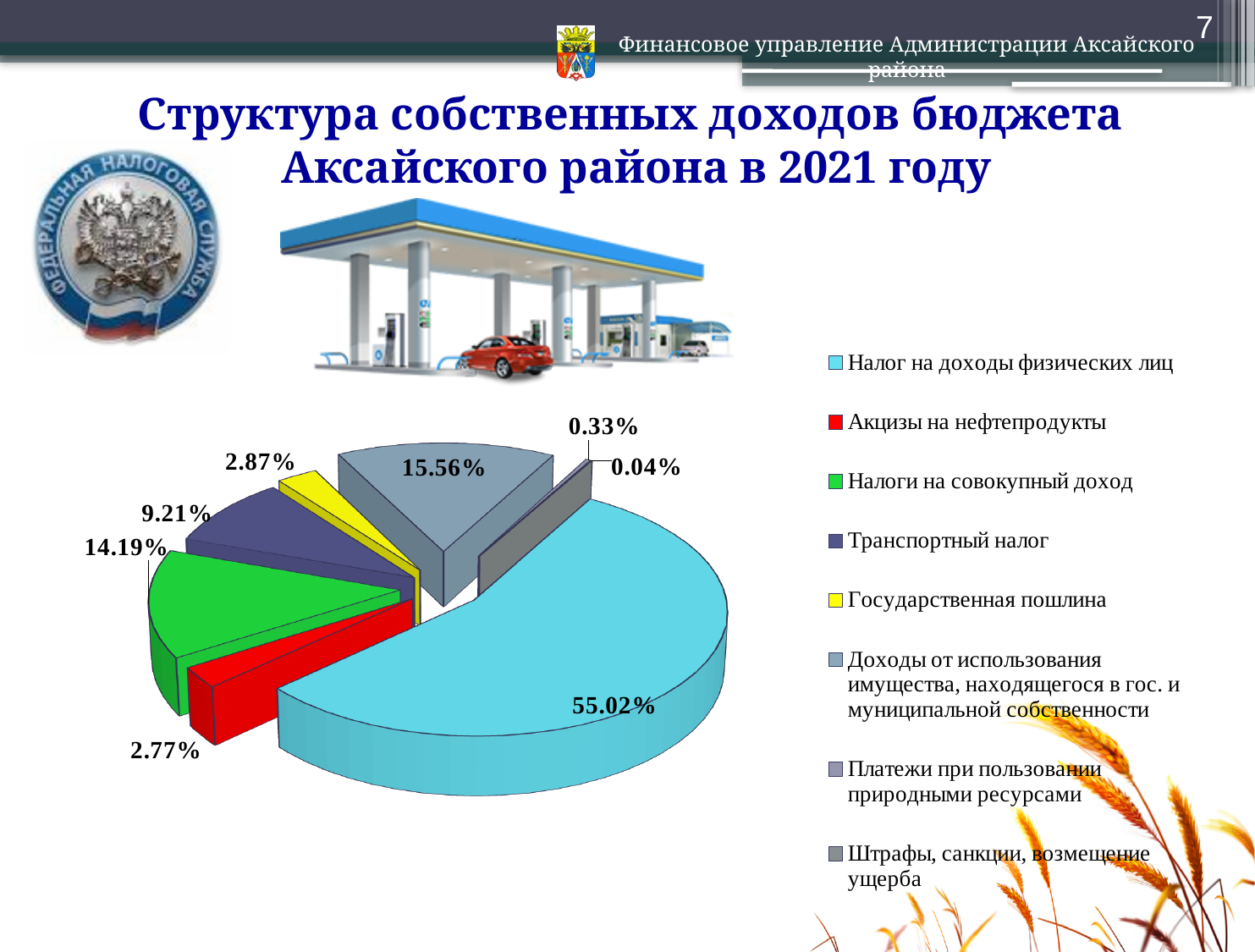
What is the difference between the shares of Доходы от использования имущества and Налоги на совокупный доход? 1.37% How many categories does the legend list? 8 What is the value shown for Доходы от использования имущества, находящегося в гос. и муниципальной собственности? 15.56% What type of chart is shown on the slide? pie chart What is the value shown for Транспортный налог? 9.21% What is the smallest percentage labelled on the pie chart? 0.04% What is the value shown for Государственная пошлина? 2.87% What is the value shown for Акцизы на нефтепродукты? 2.77% What is the value shown for Налоги на совокупный доход? 14.19% What share of the pie does Налог на доходы физических лиц have? 55.02% Which category has the largest share of the pie? Налог на доходы физических лиц Which is larger: the share of Транспортный налог or the share of Государственная пошлина? Транспортный налог